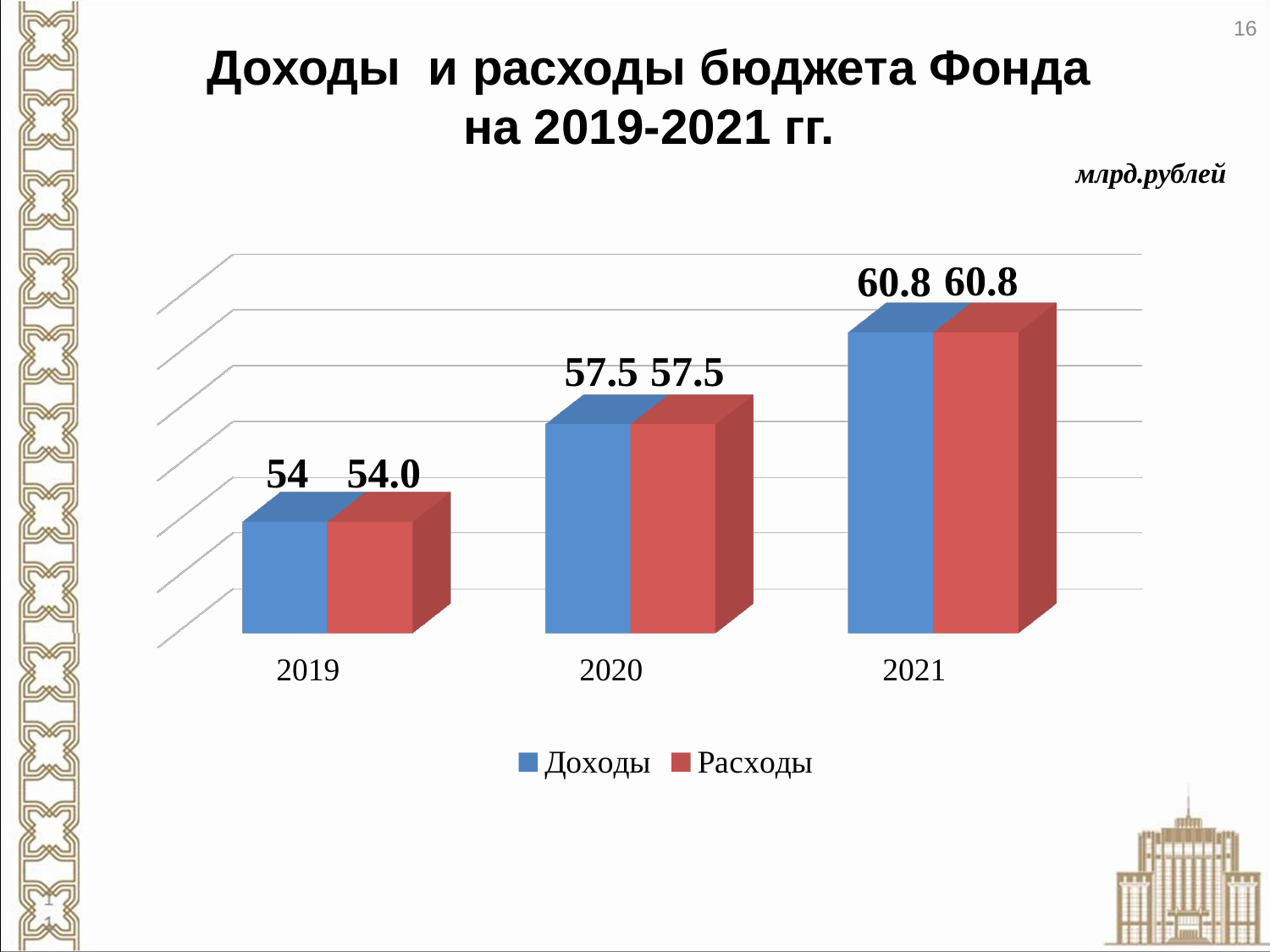
What is the value of Расходы for 2021? 60.8 What is the value of Доходы for 2020? 57.5 How many series does the legend list? 2 What is the difference between Расходы in 2020 and Расходы in 2019? 3.5 What is the difference between Доходы in 2021 and Доходы in 2019? 6.8 What is the value of Расходы for 2019? 54.0 Which year has the lowest value of Расходы? 2019 What is the value of Доходы for 2019? 54 Which year has the highest value of Доходы? 2021 Which is larger: Доходы in 2020 or Доходы in 2021? Доходы in 2021 What kind of chart is shown on the slide? Bar chart How many years are shown on the x axis? 3